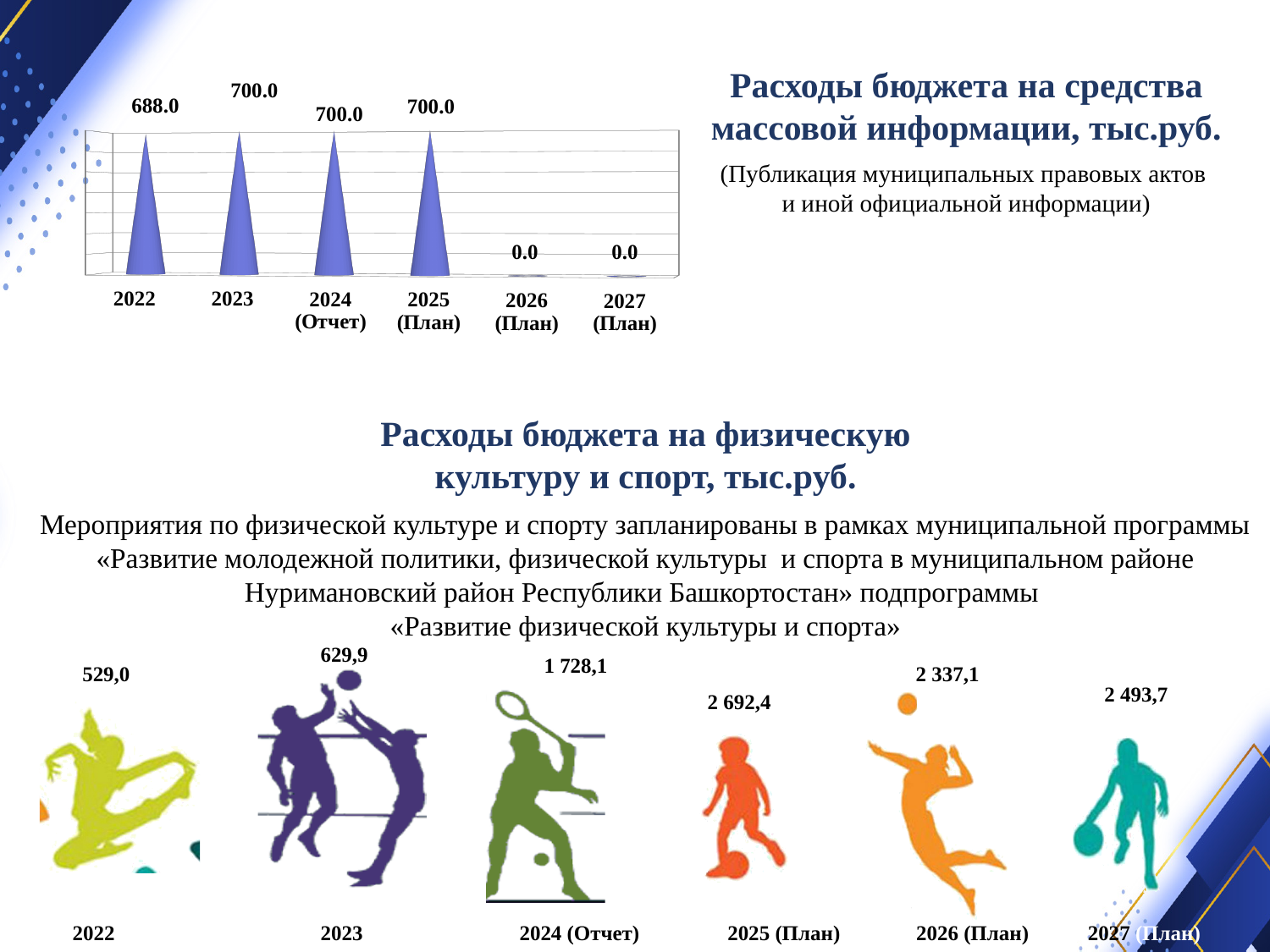
In the chart 'Расходы бюджета на средства массовой информации, тыс.руб.', what is the value for 2027 (План)? 0.0 In the chart 'Расходы бюджета на средства массовой информации, тыс.руб.', how many categories are shown on the x axis? 6 In the infographic 'Расходы бюджета на физическую культуру и спорт, тыс.руб.', what is the value for 2024 (Отчет)? 1 728,1 In the infographic 'Расходы бюджета на физическую культуру и спорт, тыс.руб.', which is larger, the value for 2026 (План) or 2027 (План)? 2027 (План) In the chart 'Расходы бюджета на средства массовой информации, тыс.руб.', what is the difference between the values for 2023 and 2022? 12.0 In the infographic 'Расходы бюджета на физическую культуру и спорт, тыс.руб.', which year has the lowest value? 2022 In the chart 'Расходы бюджета на средства массовой информации, тыс.руб.', what is the value for 2022? 688.0 What kind of chart is 'Расходы бюджета на средства массовой информации, тыс.руб.'? bar chart In the infographic 'Расходы бюджета на физическую культуру и спорт, тыс.руб.', which year has the highest value? 2025 (План) In the chart 'Расходы бюджета на средства массовой информации, тыс.руб.', which is larger, the value for 2022 or the value for 2023? 2023 In the chart 'Расходы бюджета на средства массовой информации, тыс.руб.', what is the value for 2025 (План)? 700.0 In the chart 'Расходы бюджета на средства массовой информации, тыс.руб.', do the values rise or fall from 2025 (План) to 2026 (План)? fall